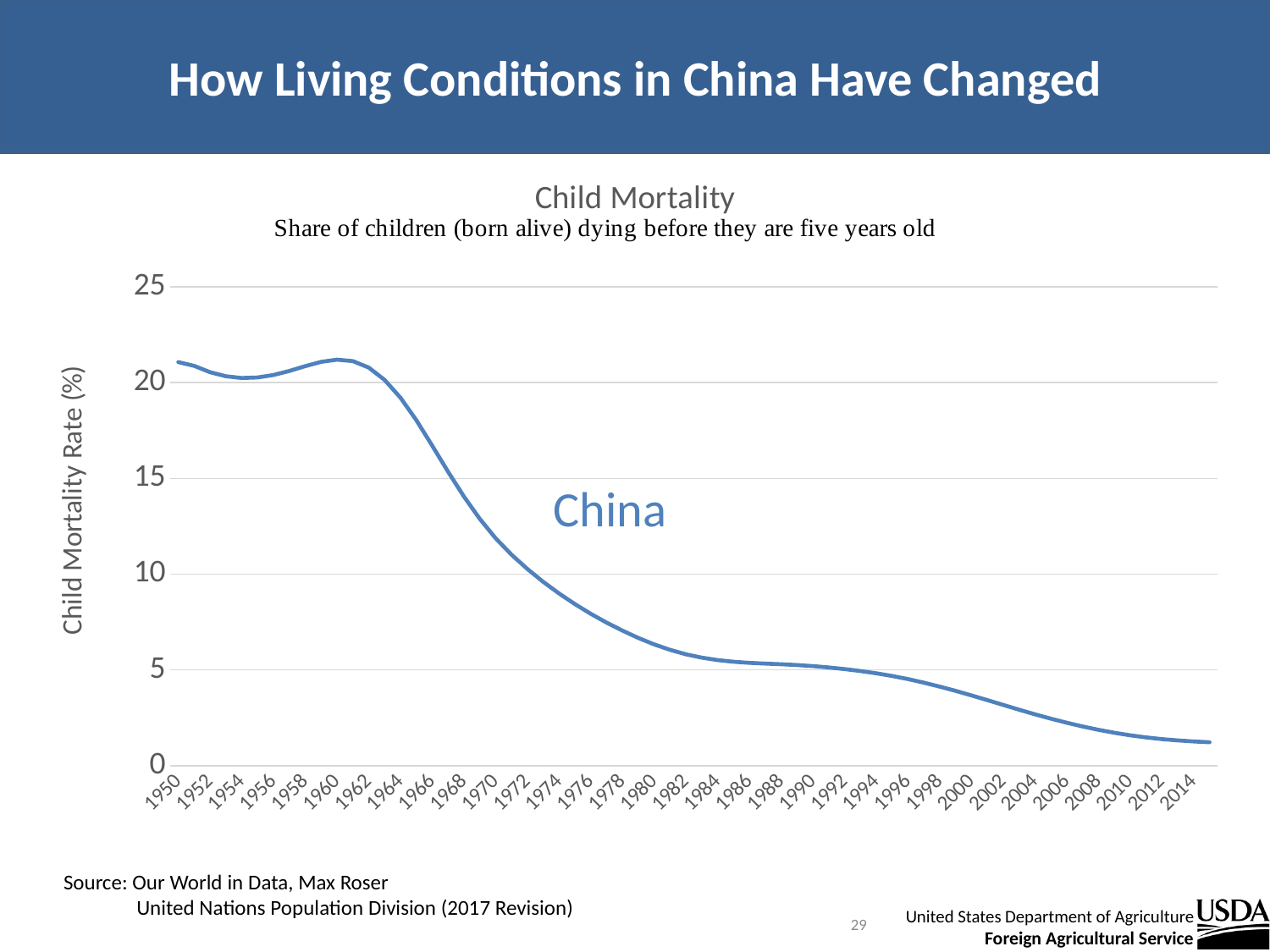
Is the child mortality rate for China in 1950 greater or less than 20? greater Is the child mortality rate for China in 2000 greater or less than 5? less Which year shown has the lowest child mortality rate for China? 2014 What kind of chart is shown on the slide? Line chart Overall, does China's child mortality rate rise or fall from 1950 to 2014? Fall Is the child mortality rate for China in 2014 greater or less than 5? less Which year has a higher child mortality rate for China, 1970 or 1990? 1970 What is the title of the chart? Child Mortality What is the label on the vertical axis of the chart? Child Mortality Rate (%) How many year labels are shown along the x axis? 33